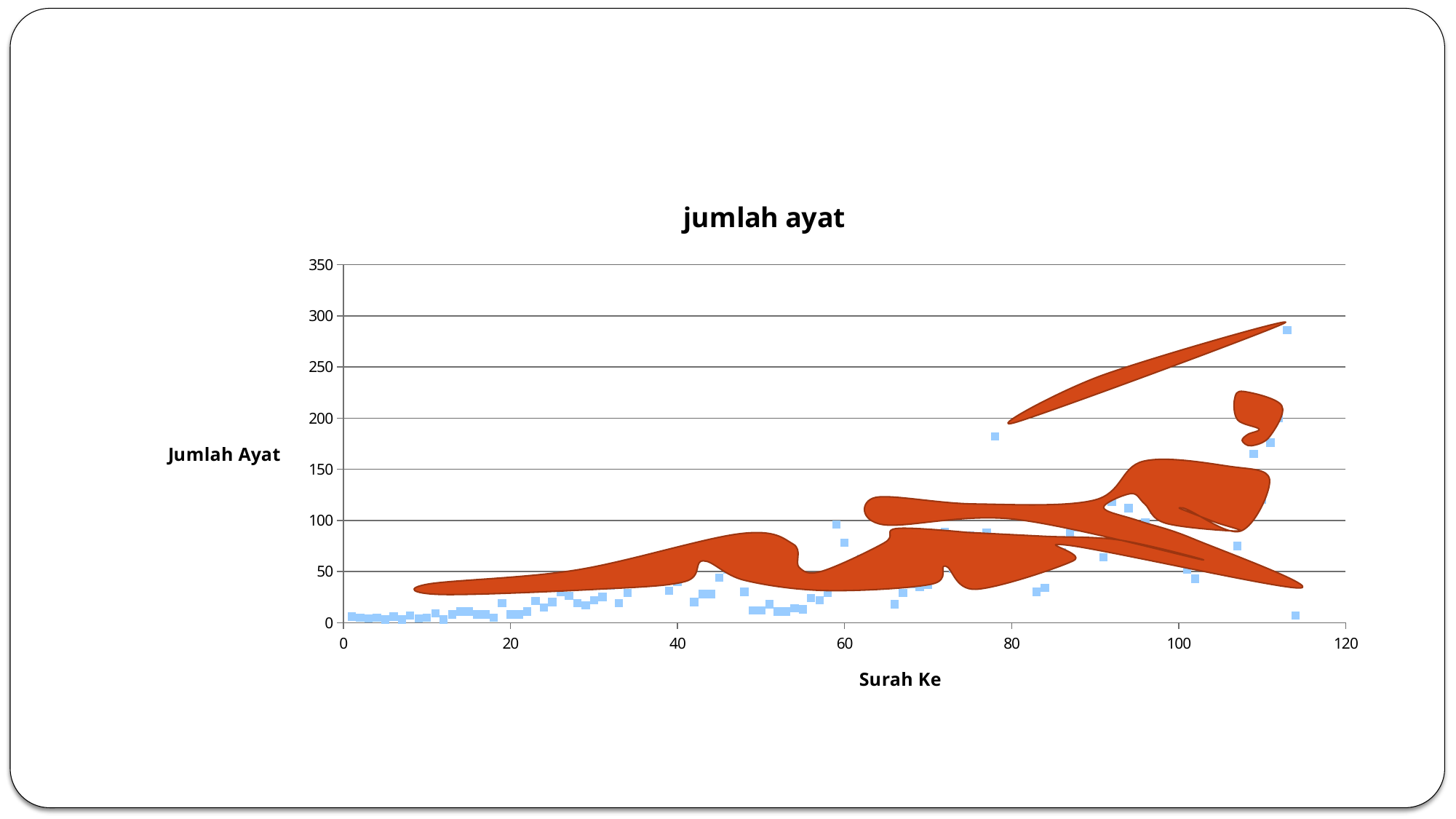
Is the last plotted point, near Surah 114, greater or less than 50? less Is the highest plotted point on the chart greater or less than 300? less What is the label on the vertical axis of the chart? Jumlah Ayat Are the plotted values for surahs numbered below 20 greater or less than 50? less What is the title of the chart? jumlah ayat Do the plotted values generally rise or fall as Surah Ke increases along the x axis? rise What kind of chart is shown on the slide? scatter chart